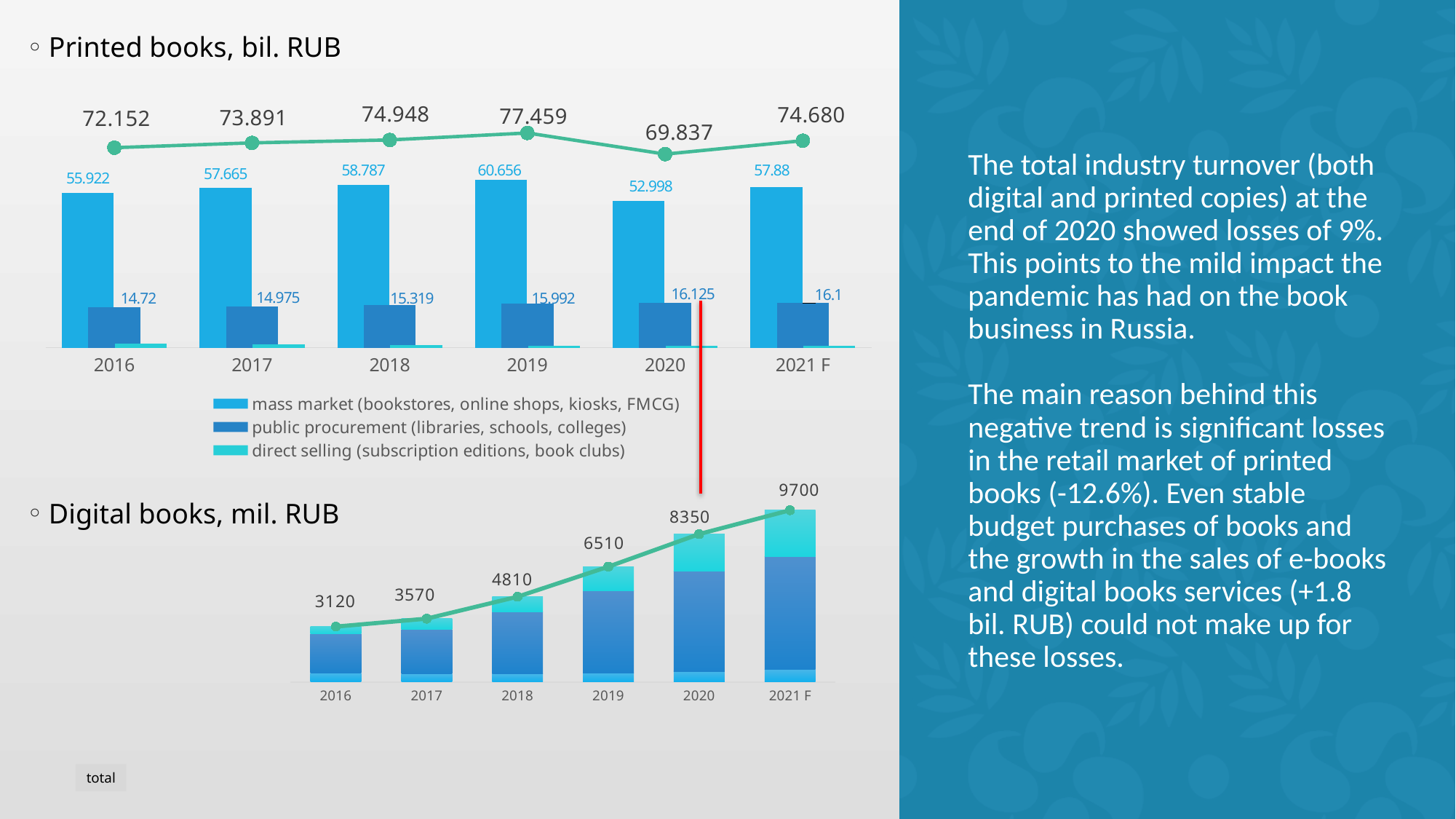
In the Printed books chart, what is the total value for 2019? 77.459 In the Printed books chart, what is the difference between the total values for 2019 and 2020? 7.622 In the Printed books chart, what is the public procurement value for 2018? 15.319 How many years are shown on the x axis of the Digital books chart? 6 In the Digital books chart, do the total values rise or fall from 2016 to 2021 F? rise In the Printed books chart, which year has the highest mass market value? 2019 In the Digital books chart, what is the difference between the total values for 2021 F and 2016? 6580 In the Printed books chart, how many series does the legend list? 3 In the Digital books chart, what is the total value for 2020? 8350 In the Printed books chart, which year has the lowest total value? 2020 In the Digital books chart, which year has the highest total value? 2021 F In the Printed books chart, what is the mass market value for 2020? 52.998